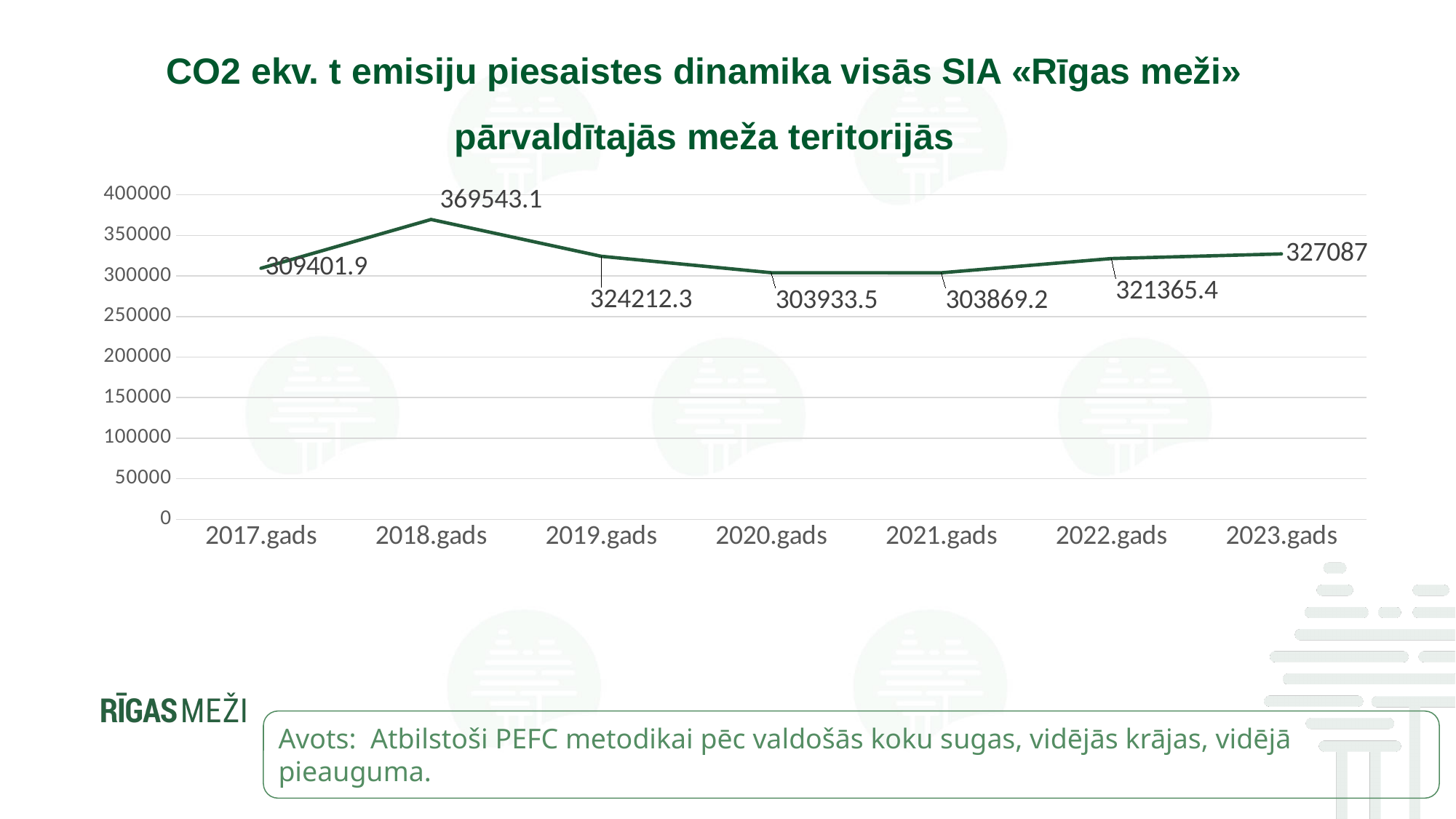
How many years are plotted on the chart? 7 Which year has the lowest value? 2021.gads Which year has the highest value? 2018.gads Do the values rise or fall from 2018.gads to 2021.gads? fall Which is larger, the value for 2019.gads or the value for 2022.gads? 2019.gads What is the value for 2018.gads? 369543.1 What is the difference between the values for 2023.gads and 2022.gads? 5721.6 What is the value for 2023.gads? 327087 What is the value for 2020.gads? 303933.5 What kind of chart is shown on the slide? line chart What is the difference between the values for 2018.gads and 2017.gads? 60141.2 Is the value for 2018.gads greater or less than 350000? greater